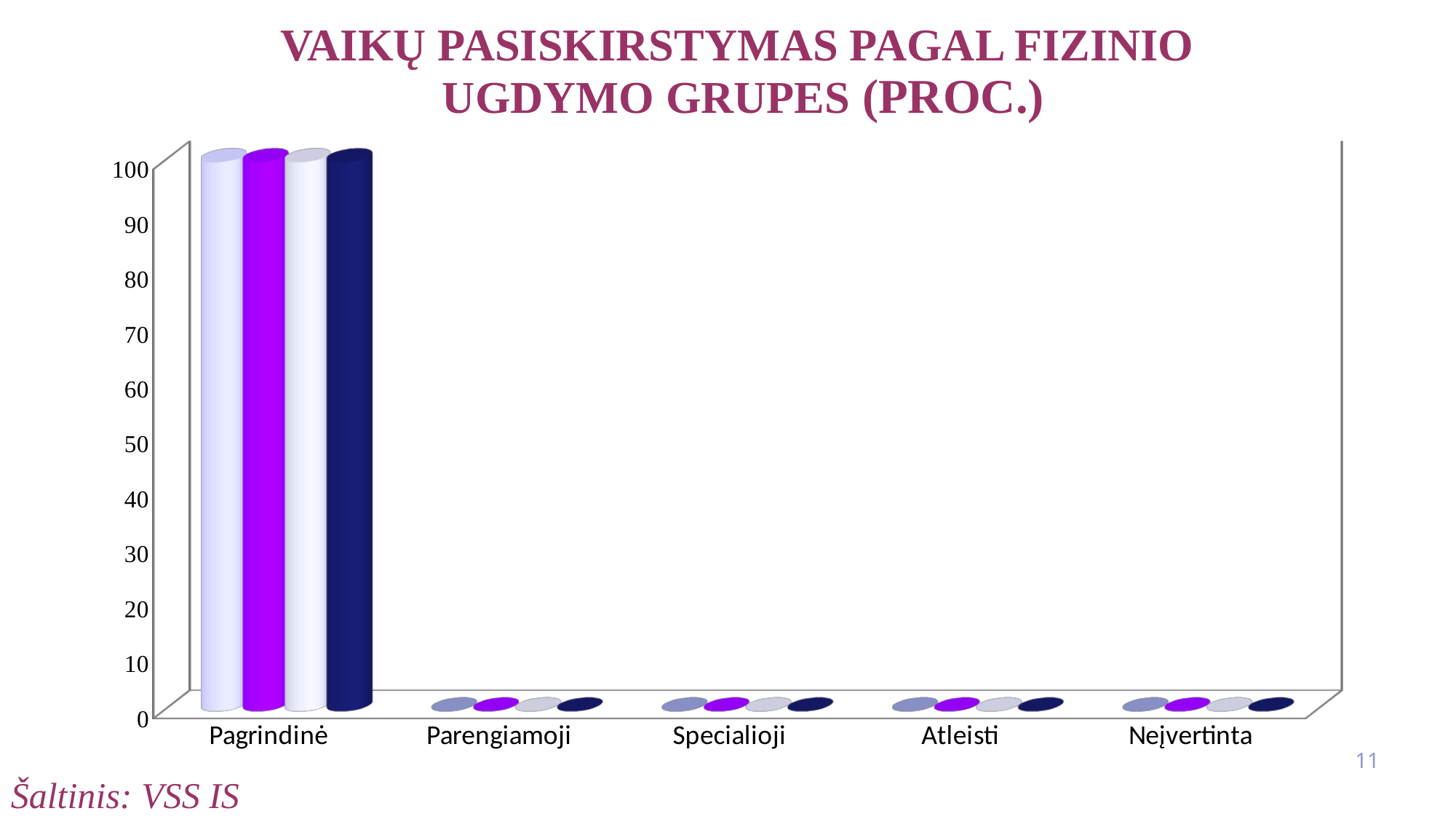
What source is cited below the chart? VSS IS Are the values for Neįvertinta greater or less than 10? less What is the title of the chart on the slide? VAIKŲ PASISKIRSTYMAS PAGAL FIZINIO UGDYMO GRUPES (PROC.) Are the values for Parengiamoji greater or less than 10? less Which category has larger values, Pagrindinė or Atleisti? Pagrindinė How many bars are plotted for each category in the chart? 4 Which category has the highest values in the chart? Pagrindinė How many categories are shown on the x axis of the chart? 5 What kind of chart is shown on the slide? bar chart Are the values for Atleisti greater or less than 10? less